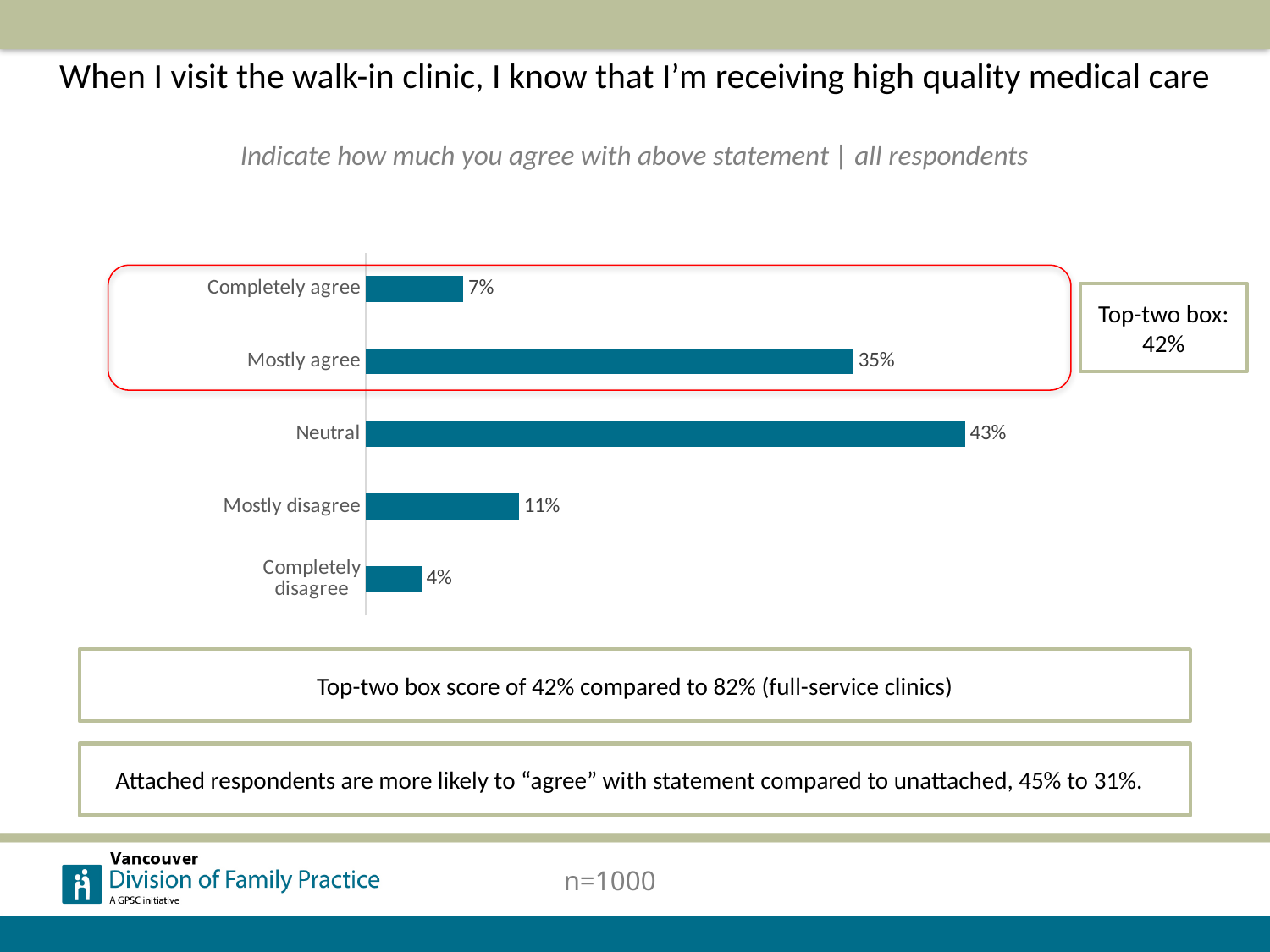
What percentage of respondents answered "Neutral"? 43% What percentage of respondents answered "Completely disagree"? 4% What percentage of respondents answered "Mostly agree"? 35% Which response category has the lowest percentage? Completely disagree Which response category has the highest percentage? Neutral What is the difference in percentage points between "Mostly agree" and "Completely agree"? 28 What is the difference in percentage points between "Neutral" and "Mostly disagree"? 32 How many response categories are shown in the chart? 5 What is the top-two box score shown in the box beside the chart? 42% Which is larger, the percentage for "Mostly disagree" or for "Completely agree"? Mostly disagree What is the combined percentage of "Completely agree" and "Mostly agree"? 42% What kind of chart is shown on the slide? Bar chart